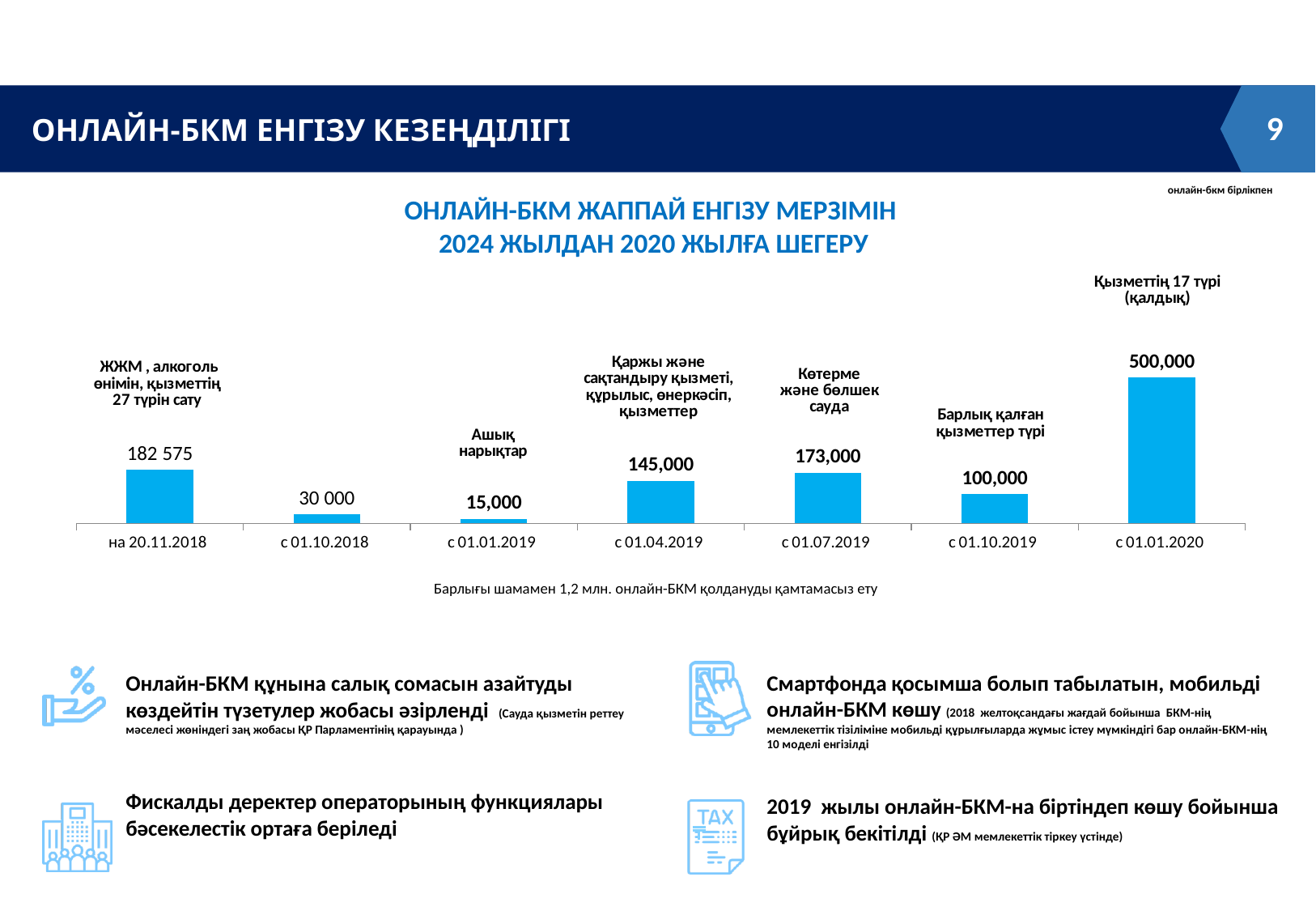
What is the value for на 20.11.2018? 182 575 What is the difference between the values for с 01.01.2020 and с 01.07.2019? 327,000 Which category has the highest value? с 01.01.2020 What kind of chart is shown on the slide? bar chart What is the title of the chart? ОНЛАЙН-БКМ ЖАППАЙ ЕНГІЗУ МЕРЗІМІН 2024 ЖЫЛДАН 2020 ЖЫЛҒА ШЕГЕРУ What is the value for с 01.04.2019? 145,000 Which is larger, the value for с 01.10.2018 or the value for с 01.10.2019? с 01.10.2019 What is the value for с 01.01.2020? 500,000 What is the difference between the values for с 01.07.2019 and с 01.04.2019? 28,000 How many categories are shown on the x axis? 7 Which category has the lowest value? с 01.01.2019 What is the value for с 01.10.2019? 100,000